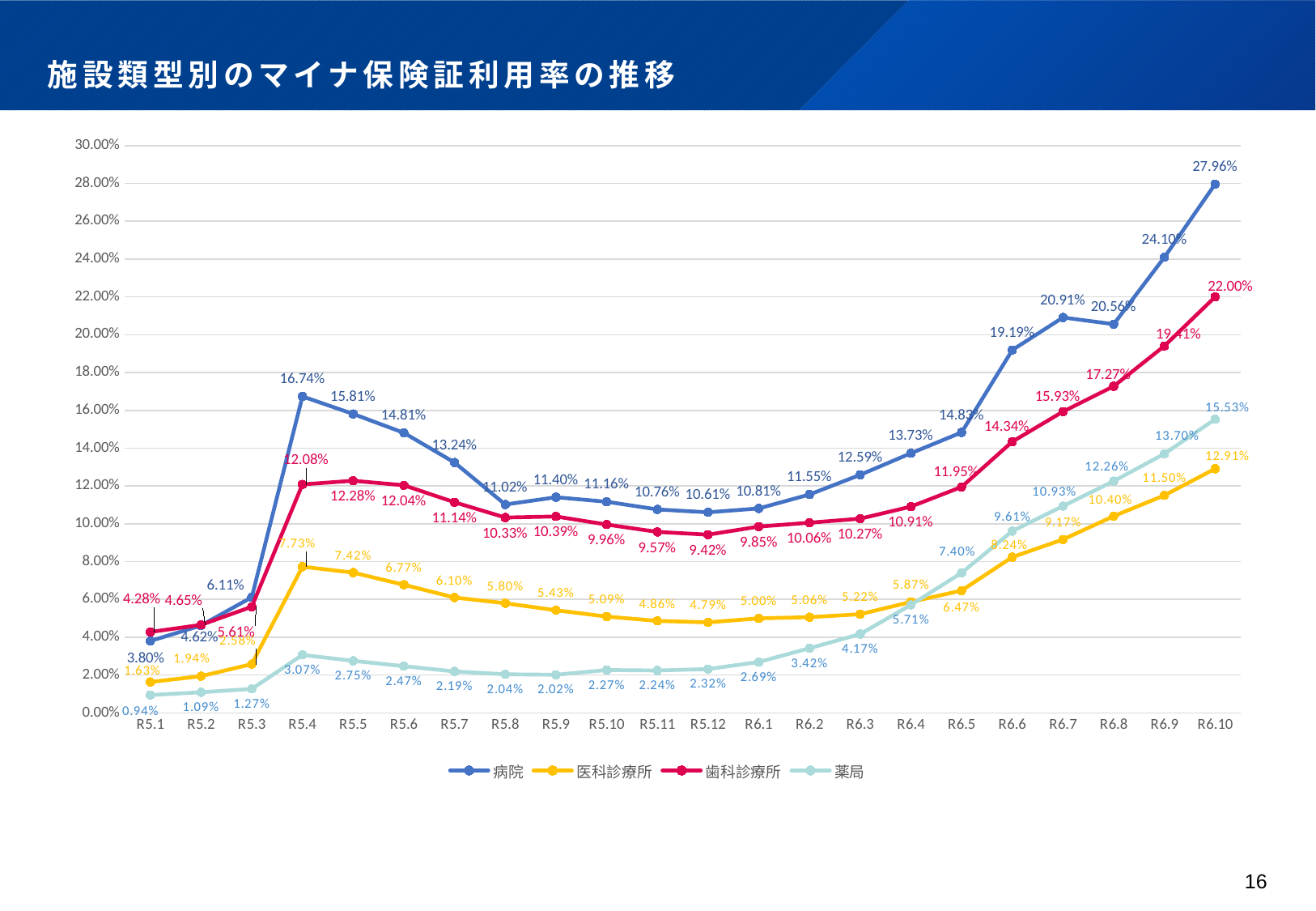
What is the value for 医科診療所 at R6.8? 10.40% What is the value for 病院 at R6.10? 27.96% How many series does the legend list? 4 What is the difference between the 病院 value at R6.10 and the 歯科診療所 value at R6.10? 5.96% What is the value for 薬局 at R5.1? 0.94% What type of chart is shown on the slide? line chart What is the title of the chart? 施設類型別のマイナ保険証利用率の推移 Which series has the lowest value at R5.1? 薬局 What is the value for 歯科診療所 at R5.4? 12.08% Which is larger at R6.3: the value for 医科診療所 or the value for 薬局? 医科診療所 How many time points are plotted along the x axis? 22 Which series has the highest value at R6.10? 病院